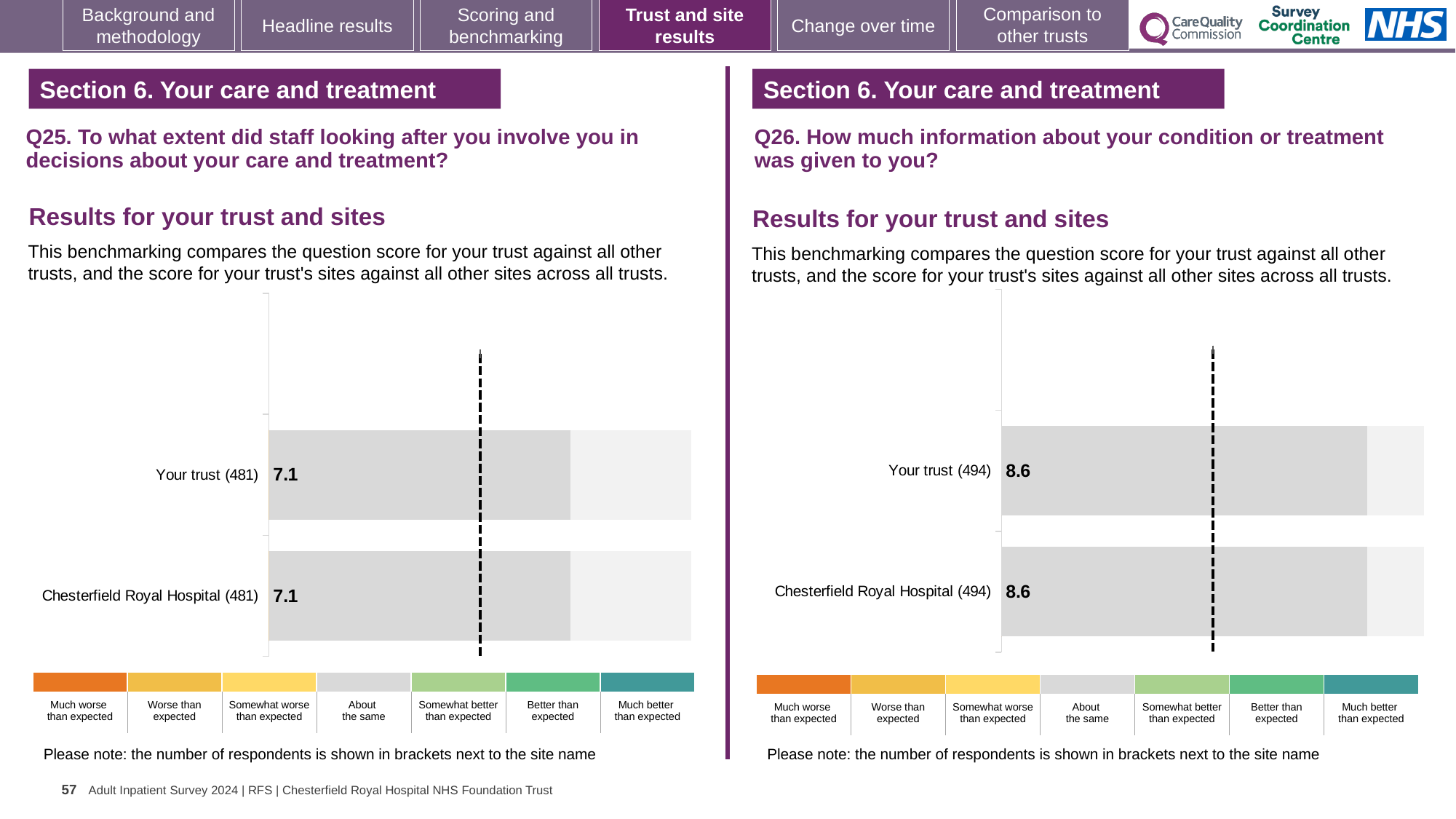
In the Q25 chart on the left, what is the score for Your trust? 7.1 In the Q25 chart on the left, what is the difference between the score for Your trust and the score for Chesterfield Royal Hospital? 0.0 In the Q25 chart on the left, how many bars are plotted? 2 In the Q26 chart on the right, how many respondents are shown in brackets next to Chesterfield Royal Hospital? 494 In the Q26 chart on the right, what is the score for Your trust? 8.6 In the Q25 chart on the left, how many respondents are shown in brackets next to Your trust? 481 In the Q26 chart on the right, what is the difference between the score for Your trust and the score for Chesterfield Royal Hospital? 0.0 In the Q26 chart on the right, how many bars are plotted? 2 What kind of chart is the Q25 chart on the left? Bar chart In the Q25 chart on the left, what is the score for Chesterfield Royal Hospital? 7.1 In the Q26 chart on the right, what is the score for Chesterfield Royal Hospital? 8.6